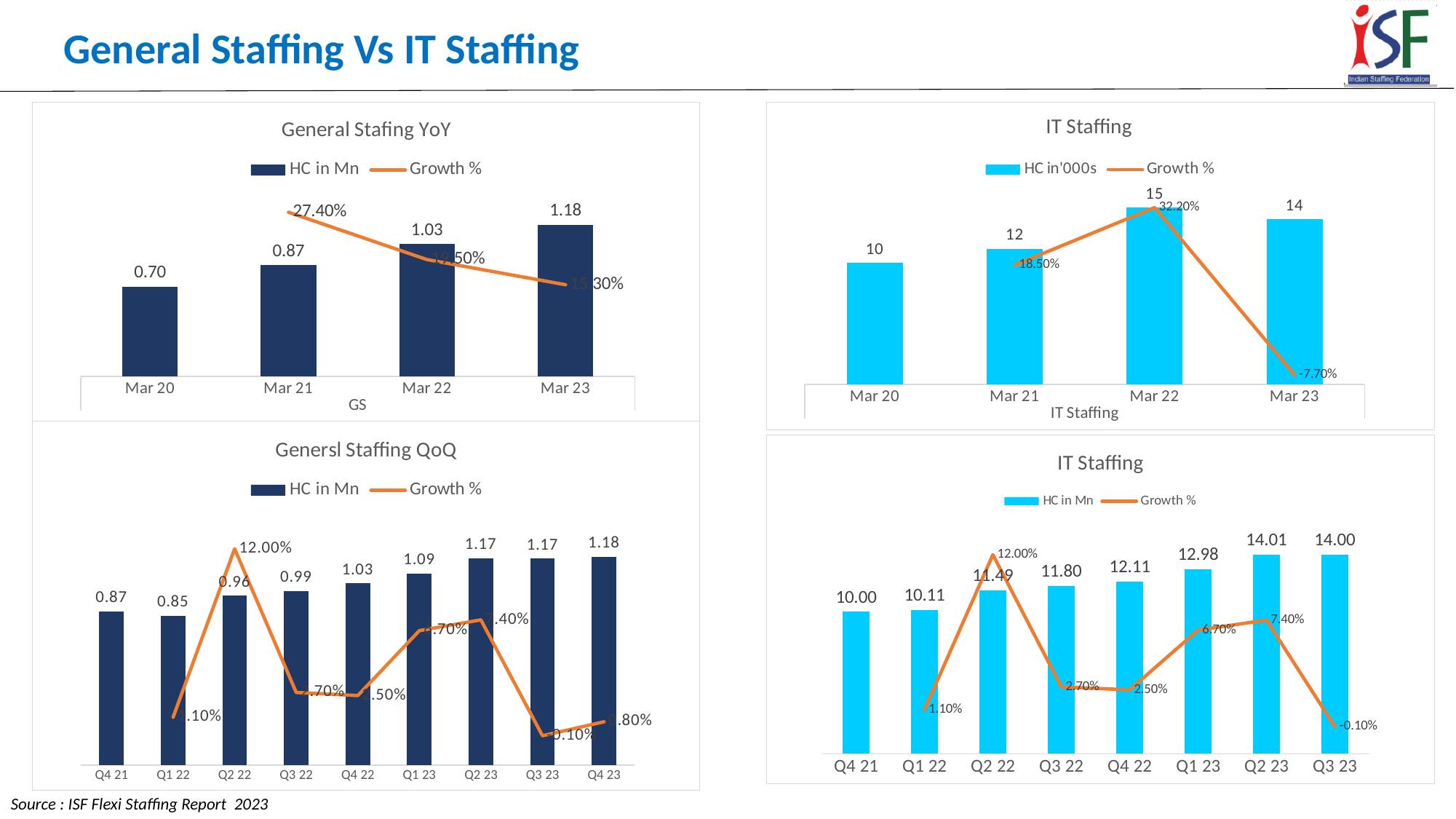
In the General Stafing YoY chart (top left), what is the Growth % value shown for Mar 21? 27.40% In the General Stafing YoY chart (top left), what is the HC in Mn value for Mar 23? 1.18 In the IT Staffing chart at the top right, which period has the highest HC in'000s value? Mar 22 In the Genersl Staffing QoQ chart (bottom left), which quarter has the lowest HC in Mn value? Q1 22 In the IT Staffing chart at the top right, what is the Growth % value for Mar 22? 32.20% In the Genersl Staffing QoQ chart (bottom left), how many quarters are shown on the x axis? 9 In the IT Staffing chart at the top right, what is the Growth % value for Mar 23? -7.70% In the IT Staffing chart at the bottom right, what is the Growth % value for Q3 23? -0.10% In the IT Staffing chart at the bottom right, what is the HC in Mn value for Q2 23? 14.01 How many series does the legend of the IT Staffing chart at the bottom right list? 2 In the Genersl Staffing QoQ chart (bottom left), what is the HC in Mn value for Q1 23? 1.09 In the General Stafing YoY chart (top left), what is the difference in HC in Mn between Mar 23 and Mar 20? 0.48